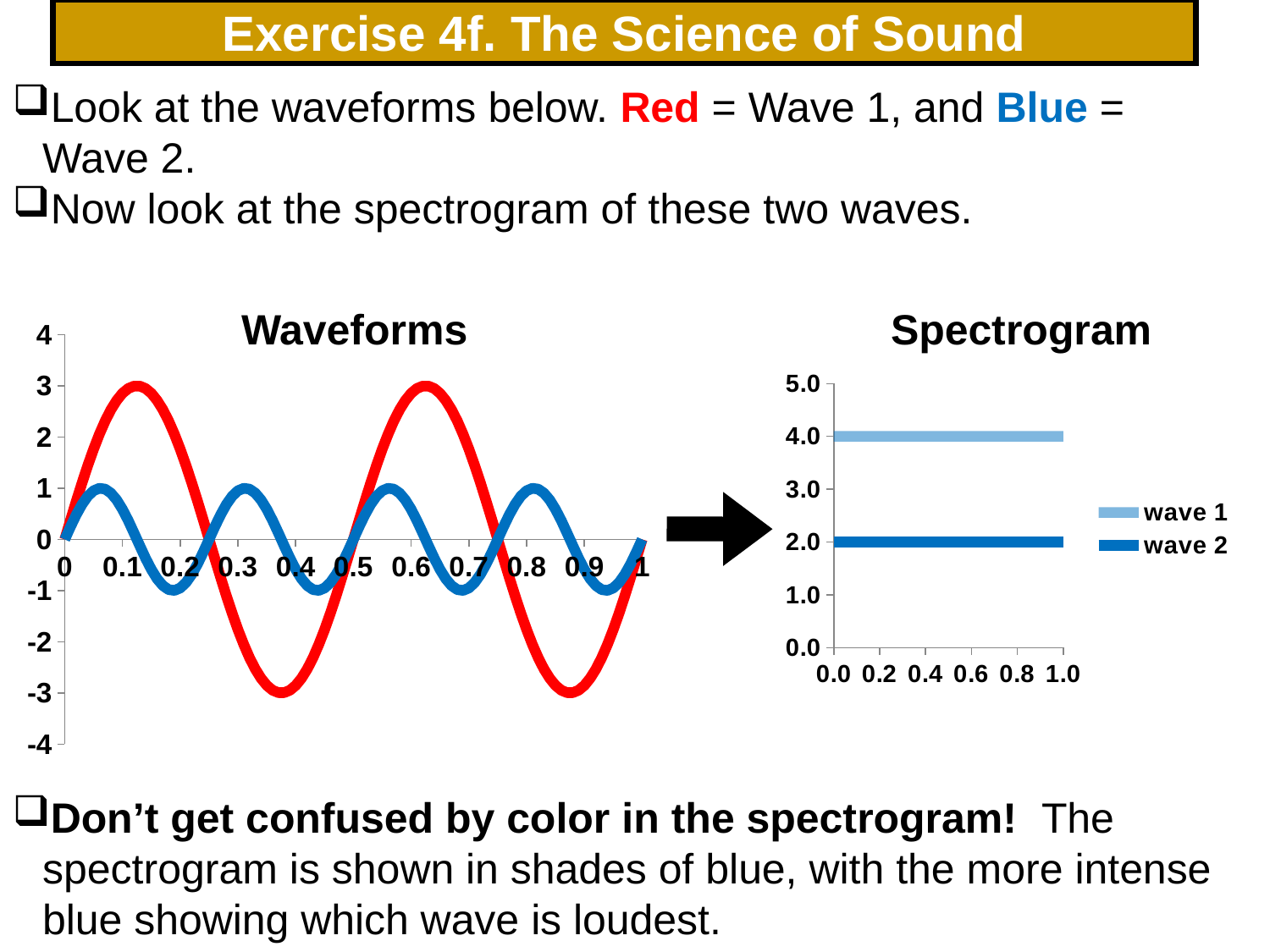
In the Spectrogram chart, which series has the higher value? wave 1 In the Spectrogram chart, what value does the wave 1 line sit at on the vertical axis? 4.0 In the Waveforms chart, is the lowest value of the red wave greater or less than -2? less What kind of chart is the Waveforms chart? line chart In the Waveforms chart, what is the highest value reached by the red wave? 3 In the Waveforms chart, which wave reaches a higher peak, the red wave or the blue wave? red wave In the Spectrogram chart, what value does the wave 2 line sit at on the vertical axis? 2.0 In the Spectrogram chart, what is the difference between the wave 1 value and the wave 2 value? 2.0 How many series does the legend of the Spectrogram chart list? 2 How many tick labels are shown on the x axis of the Waveforms chart? 11 In the Spectrogram chart, does the wave 1 line rise, fall, or stay flat along the x axis? stays flat In the Waveforms chart, what is the highest value reached by the blue wave? 1